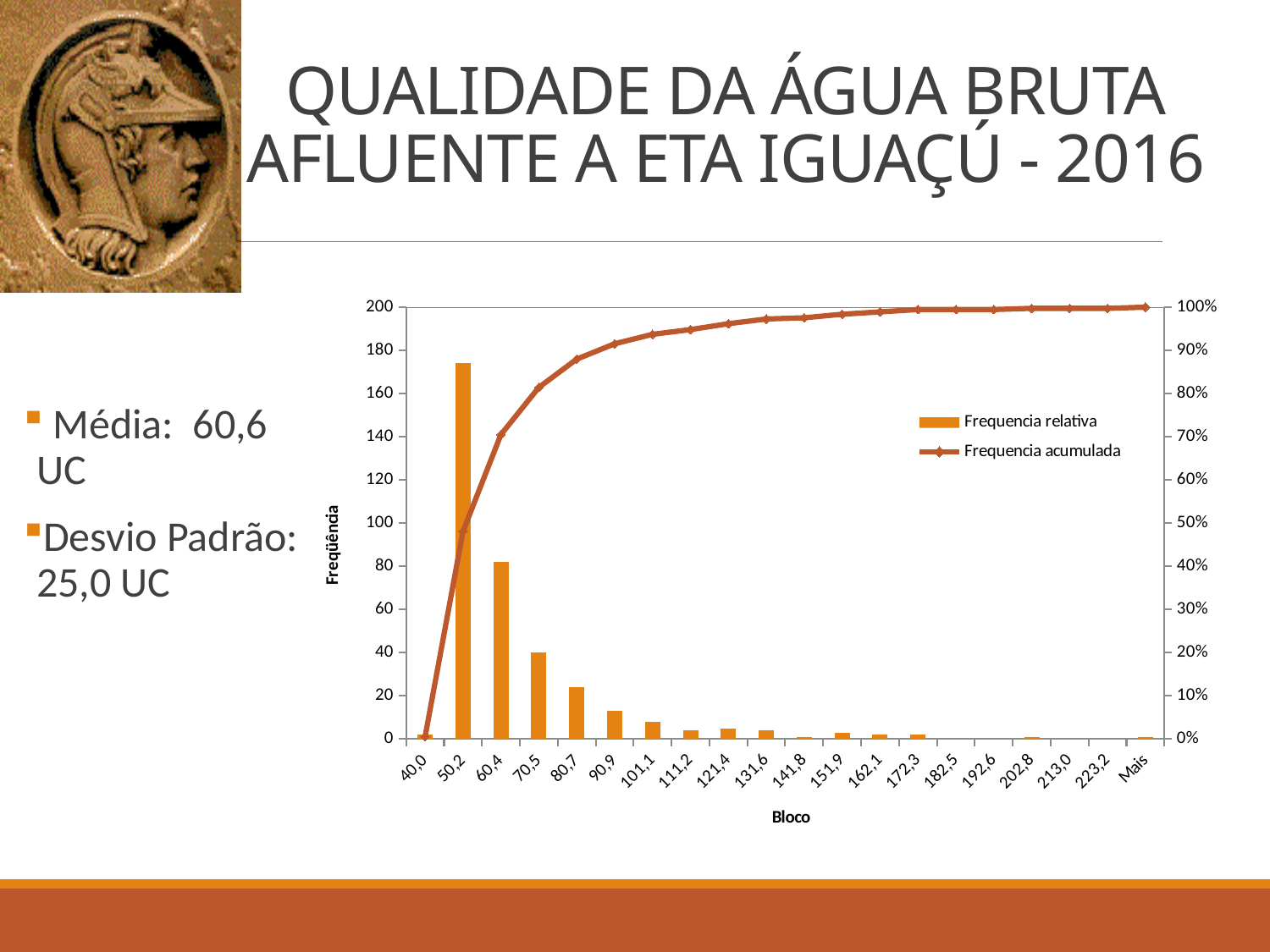
What kind of chart is shown on the slide? A bar chart combined with a line chart Which is larger, the Frequencia relativa bar for 60,4 or for 80,7? 60,4 What is the title of the x axis of the chart? Bloco How many categories are shown along the x axis of the chart? 20 How many series does the chart legend list? 2 Which category has the highest Frequencia relativa bar? 50,2 Is the Frequencia relativa value for 90,9 greater or less than 20? less Is the Frequencia relativa value for 50,2 greater or less than 160? greater Is the Frequencia relativa value for 60,4 greater or less than 100? less Does the Frequencia acumulada line rise or fall along the x axis? Rises